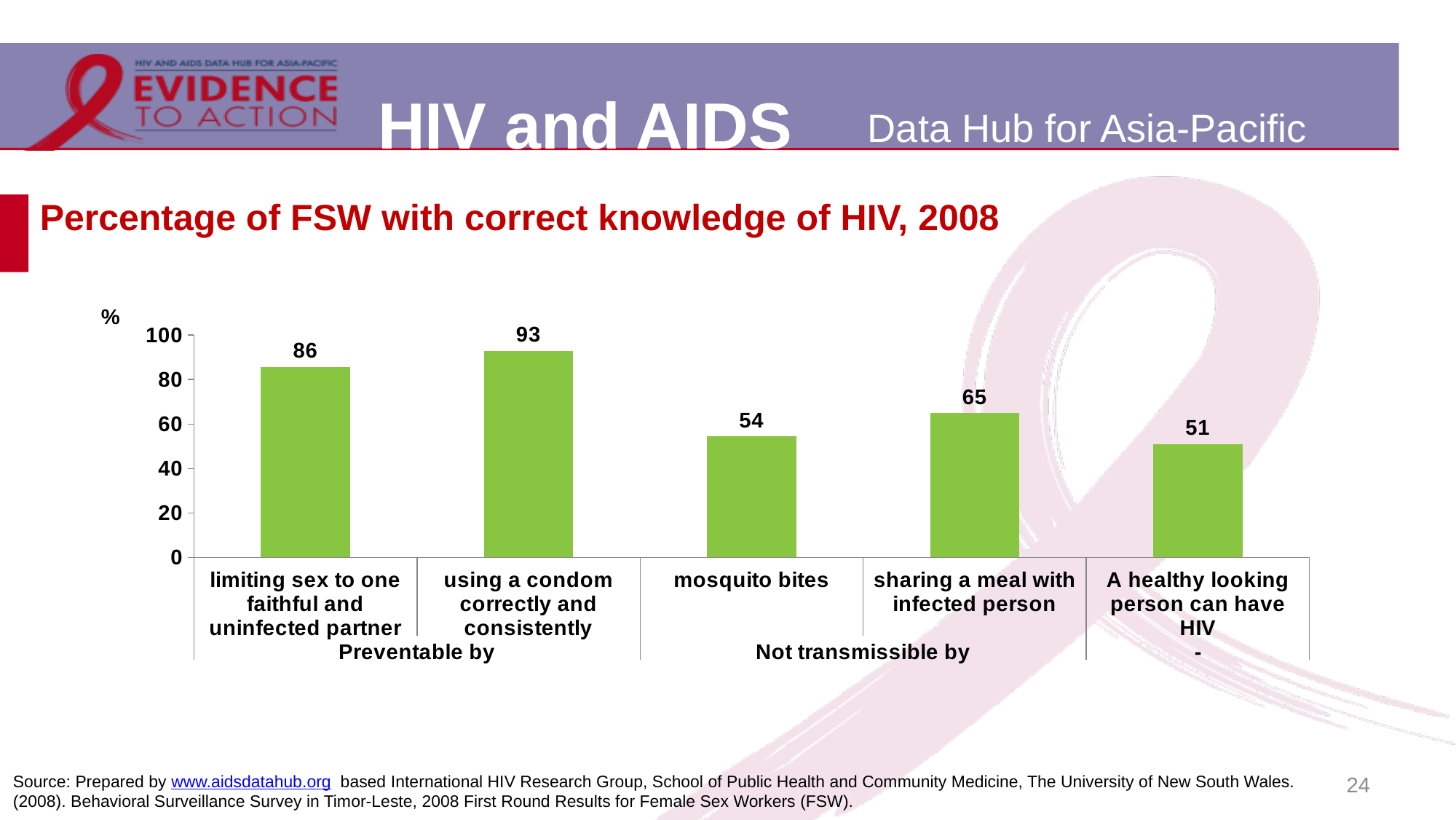
What is the value for 'mosquito bites' in the chart? 54 What is the value for 'sharing a meal with infected person'? 65 How many categories (bars) are shown in the chart? 5 What is the title of the chart on the slide? Percentage of FSW with correct knowledge of HIV, 2008 What kind of chart is shown on the slide? bar chart What is the difference between the values for 'using a condom correctly and consistently' and 'limiting sex to one faithful and uninfected partner'? 7 What is the value for 'A healthy looking person can have HIV'? 51 Which category has the lowest value in the chart? A healthy looking person can have HIV Which category has the highest value in the chart? using a condom correctly and consistently Which is larger: the value for 'mosquito bites' or the value for 'sharing a meal with infected person'? sharing a meal with infected person What is the difference between the values for 'sharing a meal with infected person' and 'mosquito bites'? 11 What percentage of FSW correctly knew that HIV is preventable by using a condom correctly and consistently? 93